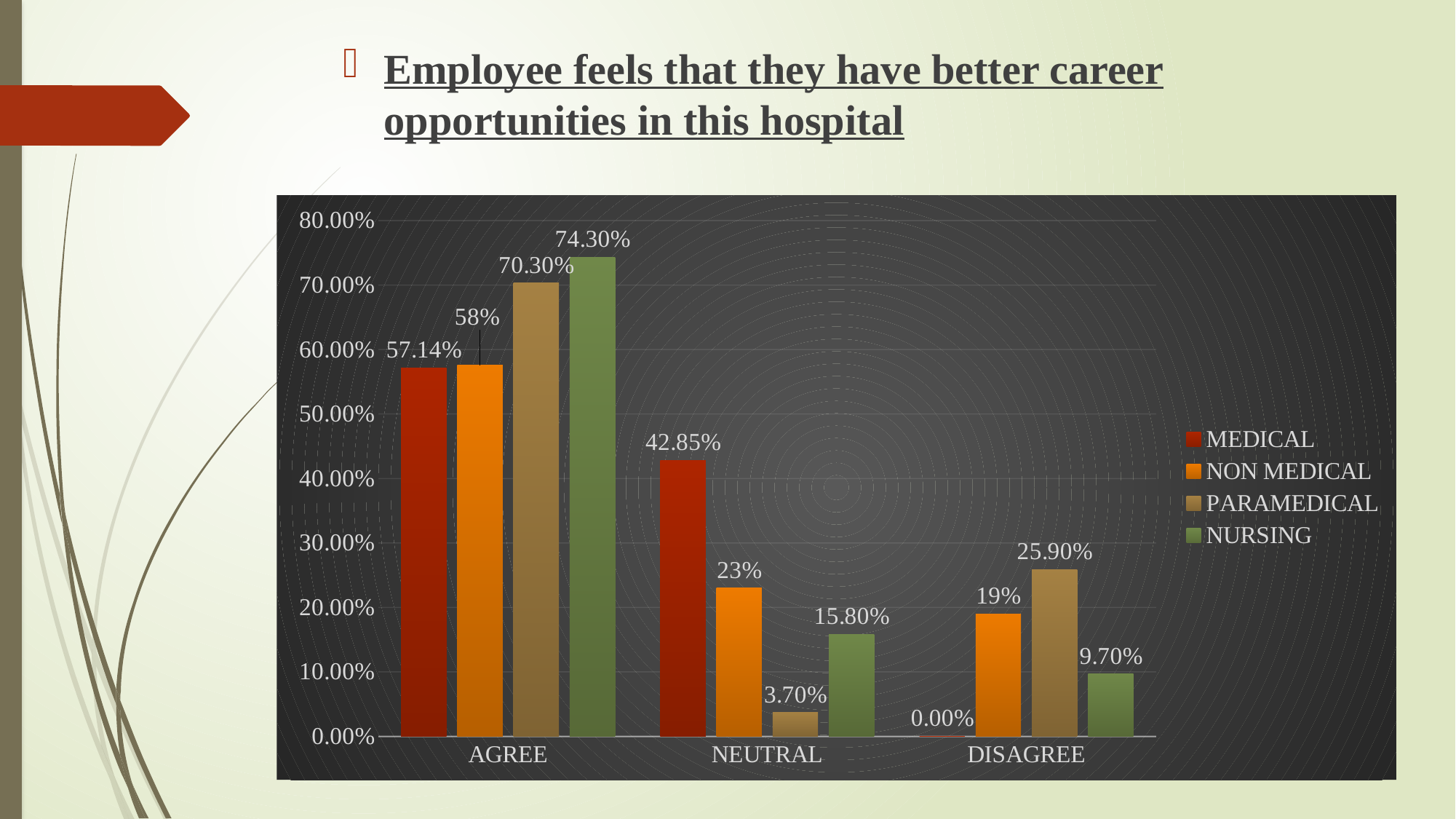
Which series has the highest value in the AGREE category? NURSING Which legend entry is shown in green? NURSING Which series has the lowest value in the NEUTRAL category? PARAMEDICAL What is the value for MEDICAL in the DISAGREE category? 0.00% What is the value for PARAMEDICAL in the DISAGREE category? 25.90% How many series does the legend list? 4 What is the value for NURSING in the AGREE category? 74.30% What is the value for MEDICAL in the NEUTRAL category? 42.85% What is the difference between the NURSING and PARAMEDICAL values in the AGREE category? 4.00% What kind of chart is shown on the slide? Bar chart Which is larger in the DISAGREE category, NON MEDICAL or NURSING? NON MEDICAL How many categories are shown on the x axis? 3